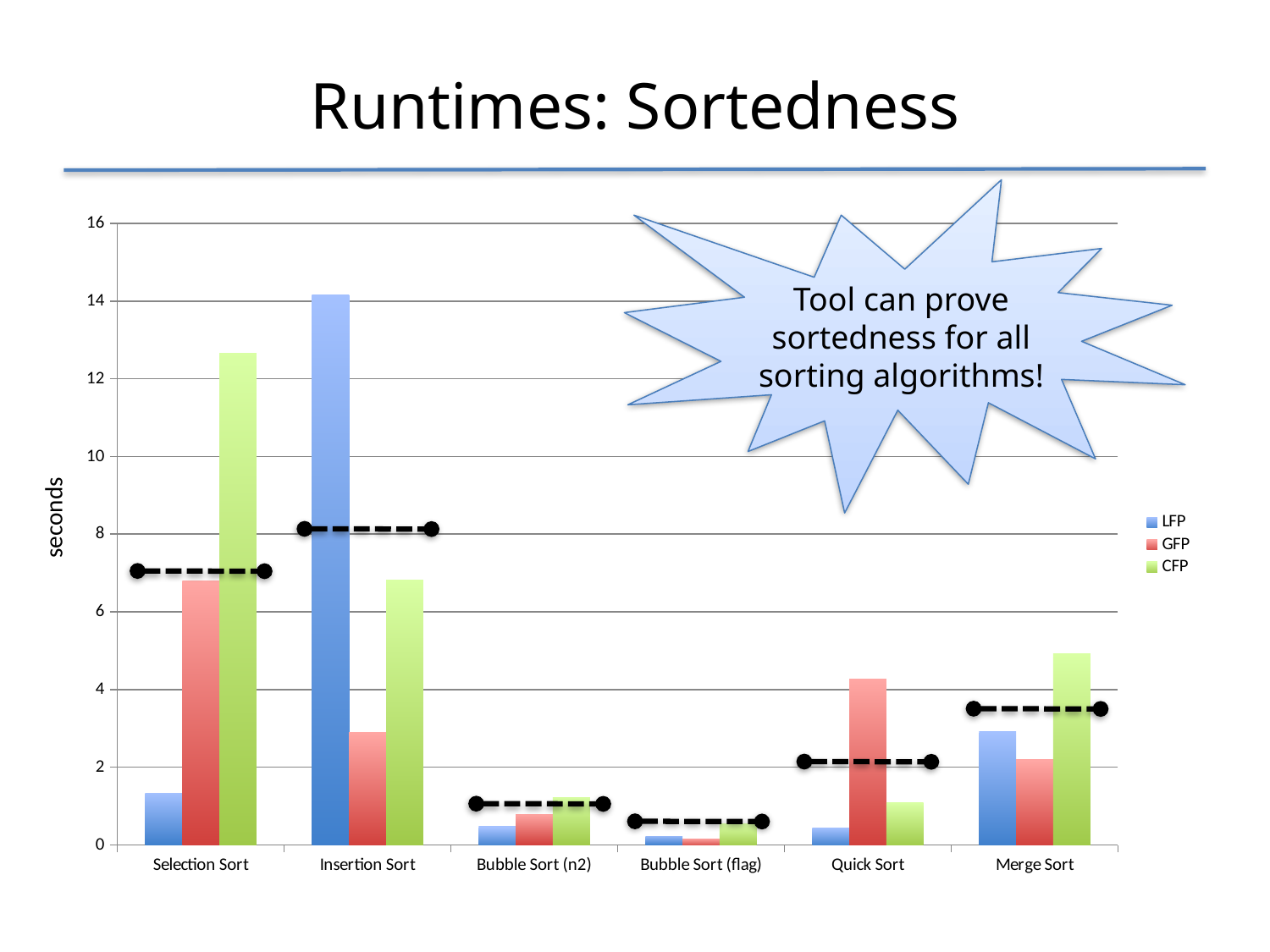
For Quick Sort, which is larger, the GFP value or the CFP value? GFP Is the CFP value for Merge Sort greater or less than 4? greater Which sorting algorithm has the highest CFP value? Selection Sort Which sorting algorithm has the lowest GFP value? Bubble Sort (flag) What are the three entries in the legend? LFP, GFP, CFP How many sorting algorithms are shown on the x axis? 6 What kind of chart is shown on the slide? bar chart Is the CFP value for Selection Sort greater or less than 10? greater Is the LFP value for Insertion Sort greater or less than 12? greater Which sorting algorithm has the highest LFP value? Insertion Sort What is the label on the y axis? seconds How many series does the legend list? 3